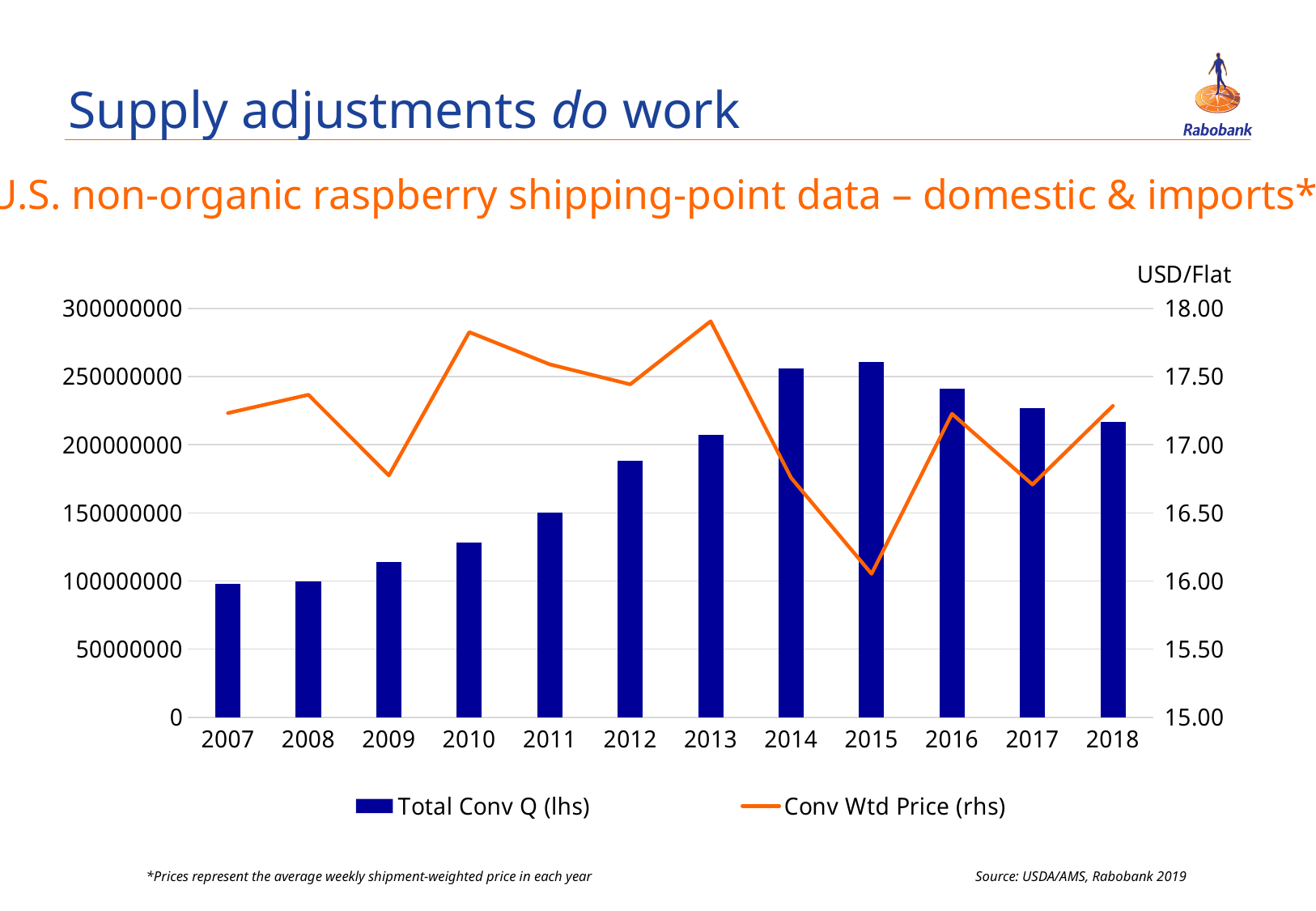
How many series does the chart legend list? 2 Is the Total Conv Q (lhs) value for 2012 greater or less than 200000000? less What unit is shown above the right-hand axis of the chart? USD/Flat Is the Conv Wtd Price (rhs) value for 2013 greater or less than 17.50? greater Which year has the highest Conv Wtd Price (rhs) value? 2013 Is the Conv Wtd Price (rhs) value for 2015 greater or less than 16.50? less Does the Total Conv Q (lhs) series rise or fall from 2007 to 2013? rise Which year has the lowest Conv Wtd Price (rhs) value? 2015 Which year has the larger Total Conv Q (lhs) value, 2016 or 2018? 2016 How many years are shown on the x axis of the chart? 12 What kind of chart is shown on the slide? A combined bar and line chart